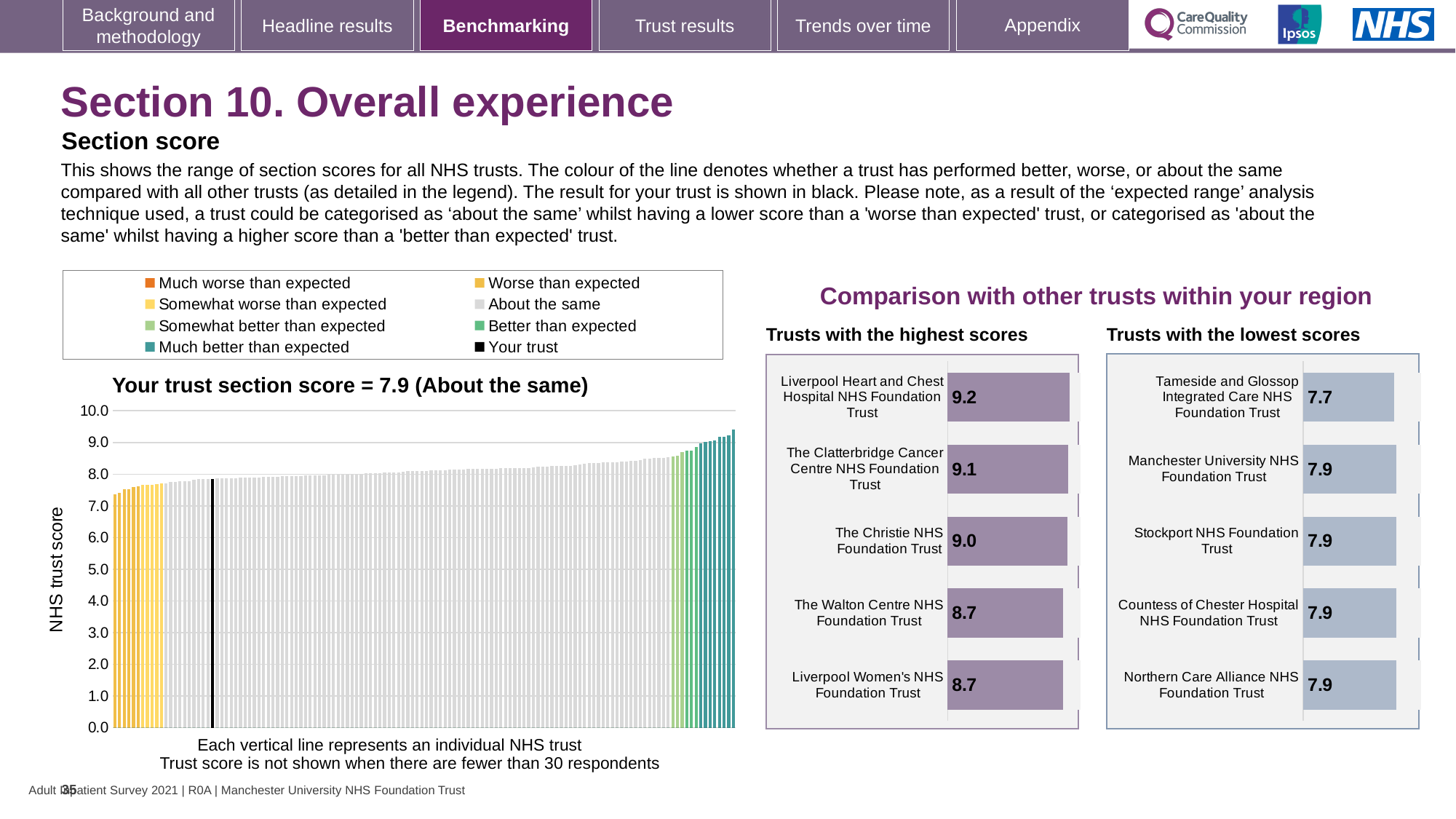
In the 'Trusts with the lowest scores' chart, which trust has the lowest score? Tameside and Glossop Integrated Care NHS Foundation Trust In the 'Trusts with the lowest scores' chart, what is the difference between the scores of Stockport NHS Foundation Trust and Tameside and Glossop Integrated Care NHS Foundation Trust? 0.2 How many trusts are listed in the 'Trusts with the lowest scores' chart? 5 In the 'Trusts with the highest scores' chart, what is the score for The Christie NHS Foundation Trust? 9.0 In the 'Trusts with the lowest scores' chart, what is the score for Tameside and Glossop Integrated Care NHS Foundation Trust? 7.7 In the 'Trusts with the highest scores' chart, what is the difference between the scores of Liverpool Heart and Chest Hospital NHS Foundation Trust and The Walton Centre NHS Foundation Trust? 0.5 In the 'Your trust section score' chart, do the bar heights rise or fall from left to right? Rise In the 'Trusts with the highest scores' chart, which trust has the highest score? Liverpool Heart and Chest Hospital NHS Foundation Trust What kind of chart is the 'Your trust section score' chart on the left? Bar chart How many entries does the legend above the 'Your trust section score' chart list? 8 In the 'Trusts with the highest scores' chart, which has the larger score: The Clatterbridge Cancer Centre NHS Foundation Trust or Liverpool Women's NHS Foundation Trust? The Clatterbridge Cancer Centre NHS Foundation Trust In the 'Trusts with the highest scores' chart, what is the score for Liverpool Heart and Chest Hospital NHS Foundation Trust? 9.2